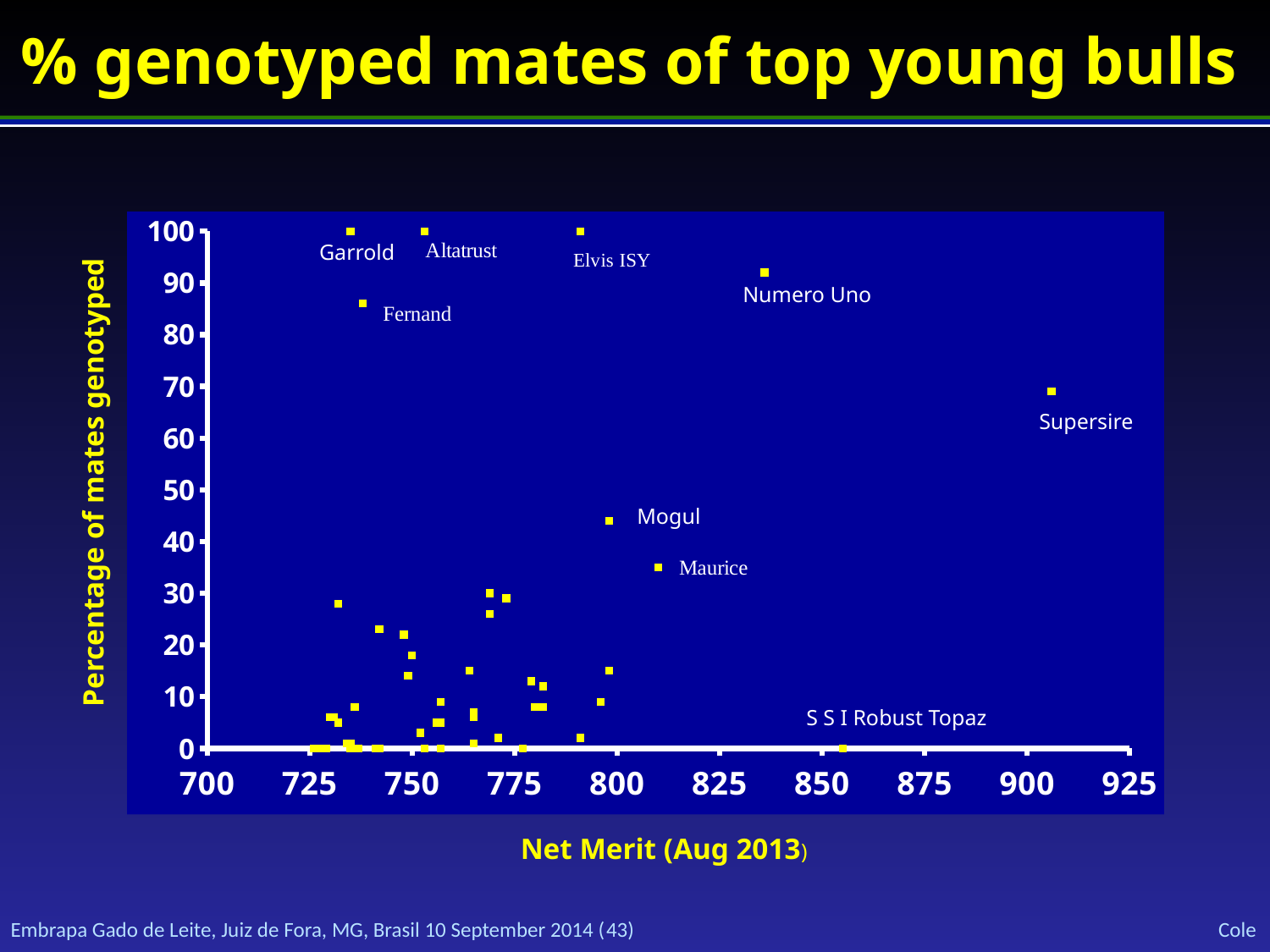
What percentage of mates genotyped is shown for Garrold? 100 Which has a higher percentage of mates genotyped, Mogul or Maurice? Mogul Is the percentage of mates genotyped for Supersire greater or less than 60? greater What percentage of mates genotyped is shown for Elvis ISY? 100 Is the Net Merit value for Supersire greater or less than 900? greater What percentage of mates genotyped is shown for S S I Robust Topaz? 0 Is the percentage of mates genotyped for Fernand greater or less than 80? greater What is the title of the x axis? Net Merit (Aug 2013) Which has a higher percentage of mates genotyped, Supersire or Numero Uno? Numero Uno What kind of chart is shown on the slide? scatter chart